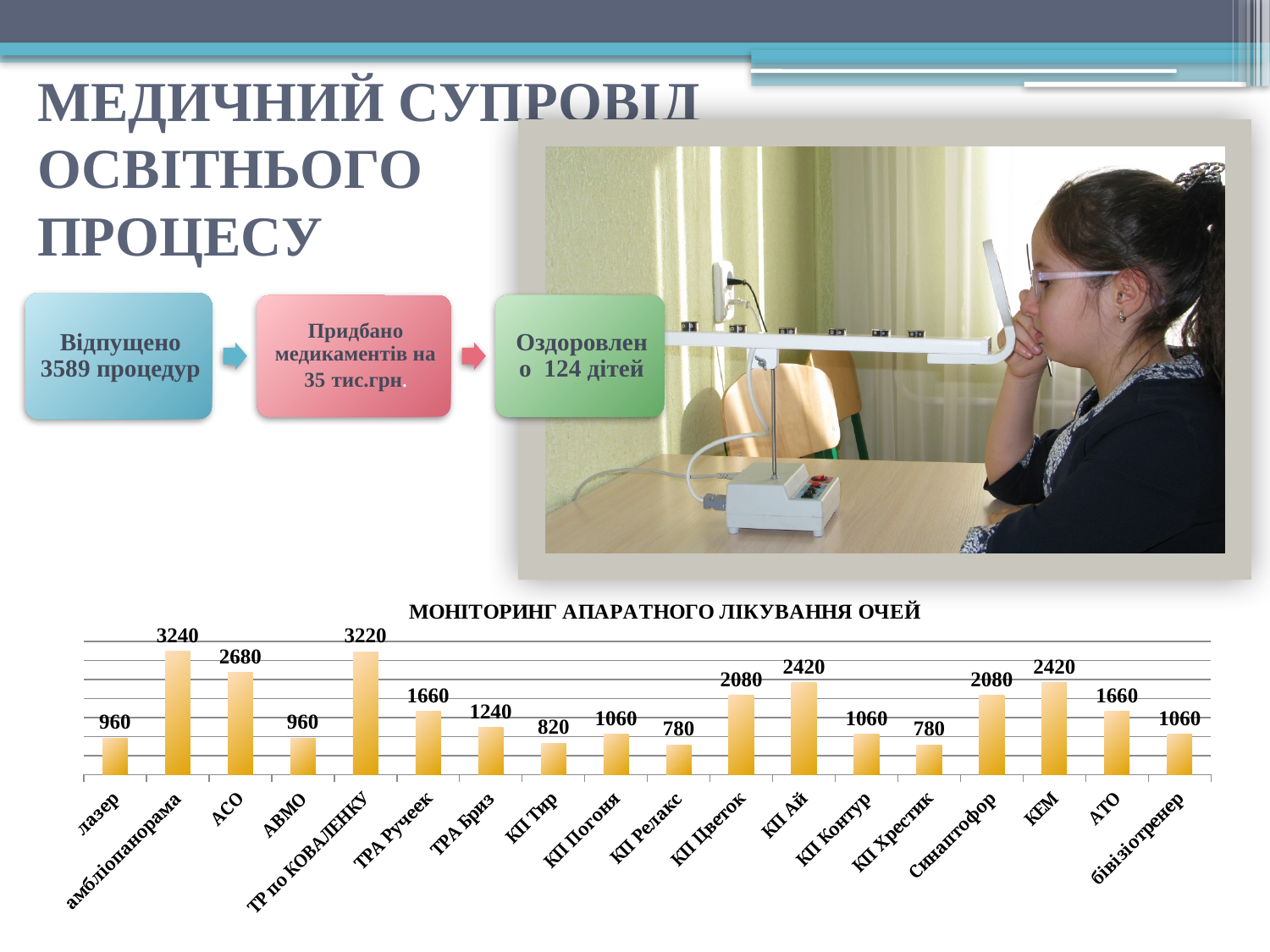
What is the difference between the values for АСО and АВМО? 1720 What is the value for ТР по КОВАЛЕНКУ? 3220 Which category has the highest value in the chart? амбліопанорама Which is larger, the value for КП Цветок or the value for КЕМ? КЕМ What is the difference between the values for КП Ай and КП Контур? 1360 How many categories are shown on the x axis of the chart? 18 Which is larger, the value for ТРА Ручеек or the value for ТРА Бриз? ТРА Ручеек What is the value for амбліопанорама in the chart МОНІТОРИНГ АПАРАТНОГО ЛІКУВАННЯ ОЧЕЙ? 3240 What is the value for Синаптофор? 2080 What kind of chart is shown at the bottom of the slide? bar chart What is the value for КП Тир? 820 What is the title of the chart on the slide? МОНІТОРИНГ АПАРАТНОГО ЛІКУВАННЯ ОЧЕЙ